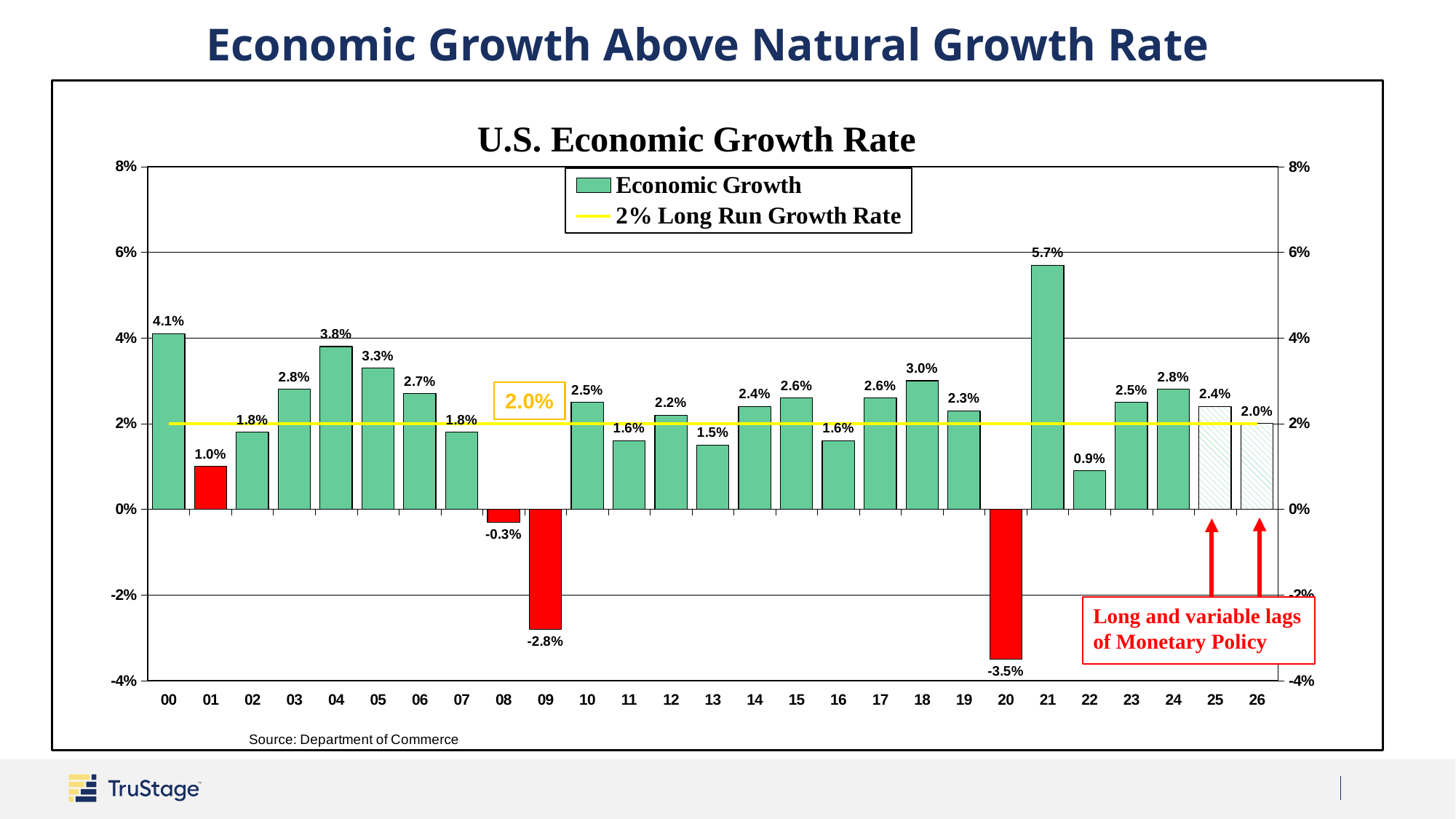
What is the economic growth rate shown for 2009? -2.8% What is the economic growth rate shown for 2025? 2.4% Which year has the highest economic growth rate? 21 What kind of chart is used to show the U.S. Economic Growth Rate? bar chart What is the difference between the growth rate in 2000 and the growth rate in 2001? 3.1% How many years are shown on the x axis of the chart? 27 What value does the yellow horizontal line represent? 2% Long Run Growth Rate Is the growth rate for 2022 greater or less than 2%? less Which year has the lowest economic growth rate? 20 What is the economic growth rate shown for 2021? 5.7% How many series does the legend list? 2 Which year has a higher growth rate, 2004 or 2005? 04